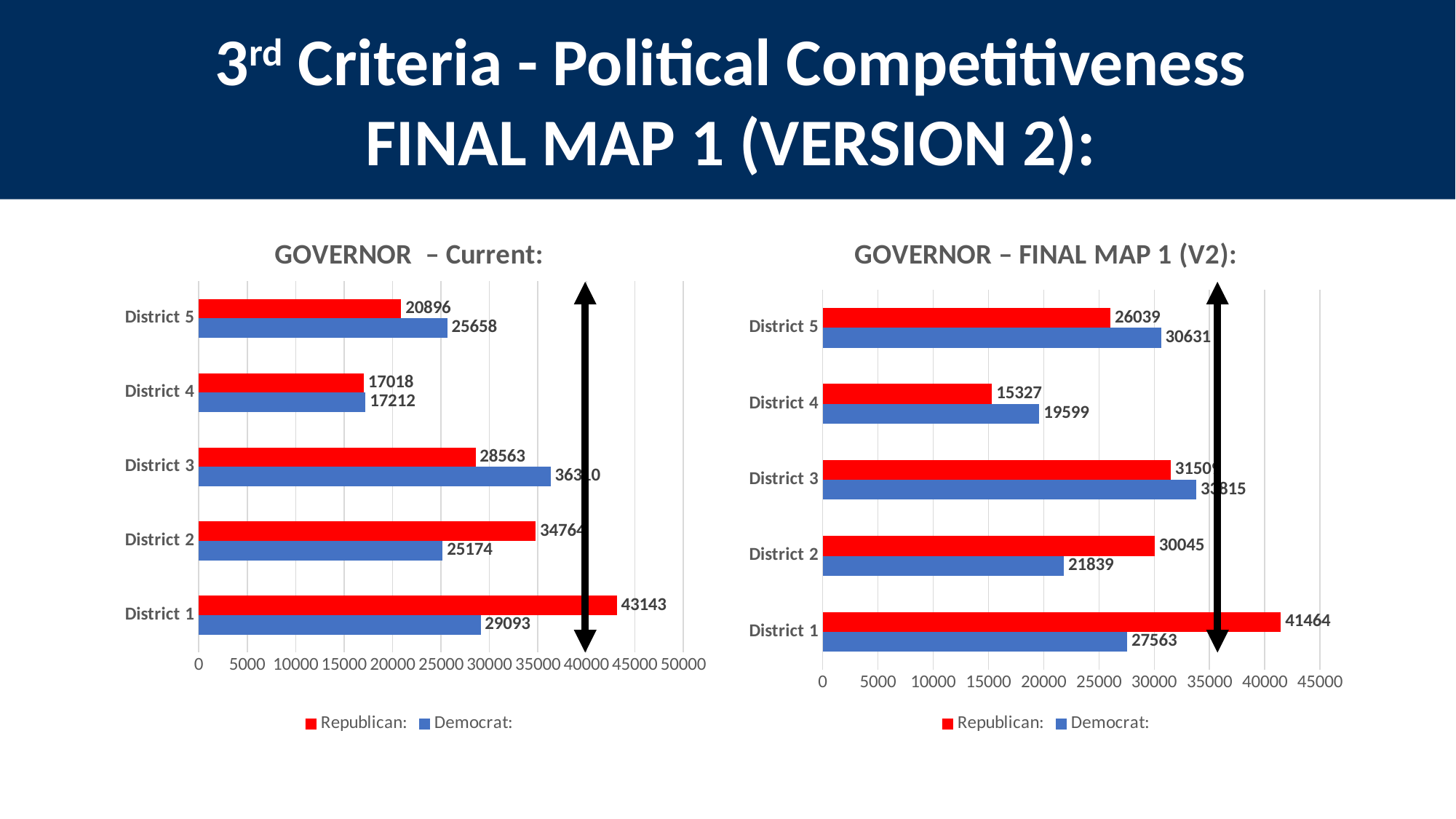
In the GOVERNOR – Current chart, what is the Democrat value for District 5? 25658 In the GOVERNOR – FINAL MAP 1 (V2) chart, what is the difference between the Democrat and Republican values for District 5? 4592 In the GOVERNOR – FINAL MAP 1 (V2) chart, is the Republican value for District 1 greater or less than 40000? greater How many districts are shown in the GOVERNOR – Current chart? 5 In the GOVERNOR – Current chart, which is larger for District 4, the Republican value or the Democrat value? Democrat In the GOVERNOR – FINAL MAP 1 (V2) chart, which district has the lowest Republican value? District 4 In the GOVERNOR – FINAL MAP 1 (V2) chart, what is the Republican value for District 2? 30045 In the GOVERNOR – Current chart, what is the Republican value for District 1? 43143 In the GOVERNOR – Current chart, which district has the highest Republican value? District 1 In the GOVERNOR – FINAL MAP 1 (V2) chart, what is the Democrat value for District 4? 19599 How many series does the legend of the GOVERNOR – FINAL MAP 1 (V2) chart list? 2 In the GOVERNOR – Current chart, what is the difference between the Republican and Democrat values for District 2? 9590